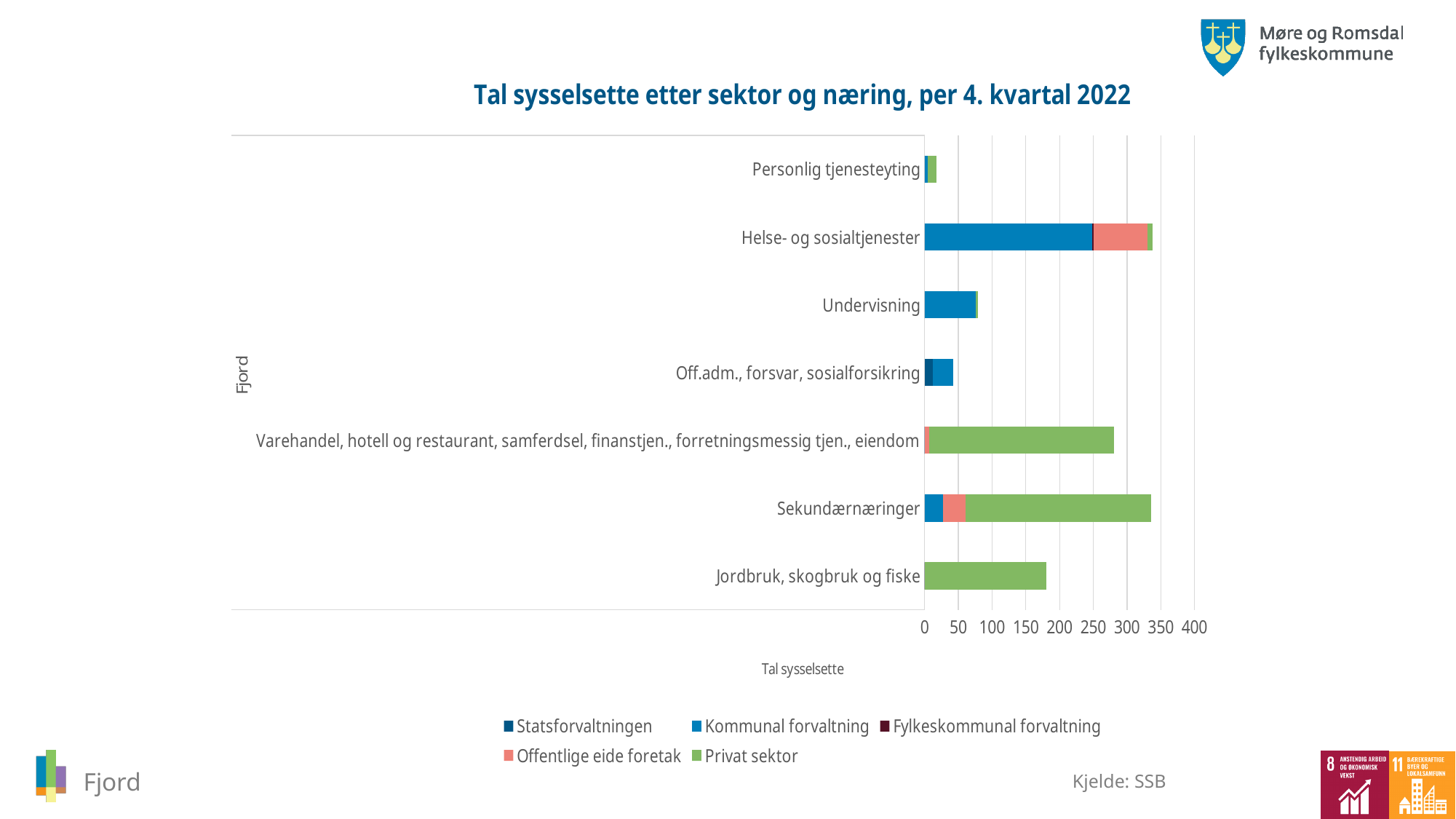
Which has a larger total: Jordbruk, skogbruk og fiske or Undervisning? Jordbruk, skogbruk og fiske Which series is shown in green in the legend? Privat sektor Which has a larger total: Varehandel, hotell og restaurant, samferdsel, finanstjen., forretningsmessig tjen., eiendom or Off.adm., forsvar, sosialforsikring? Varehandel, hotell og restaurant, samferdsel, finanstjen., forretningsmessig tjen., eiendom Which category has the lowest total number of employed (sysselsette)? Personlig tjenesteyting Is the total value for Helse- og sosialtjenester greater or less than 300? greater Is the total value for Off.adm., forsvar, sosialforsikring greater or less than 50? less What kind of chart is shown on the slide? Bar chart Is the total value for Jordbruk, skogbruk og fiske greater or less than 150? greater What is the title of the chart? Tal sysselsette etter sektor og næring, per 4. kvartal 2022 How many categories (næringer) are plotted on the chart? 7 How many series does the legend list? 5